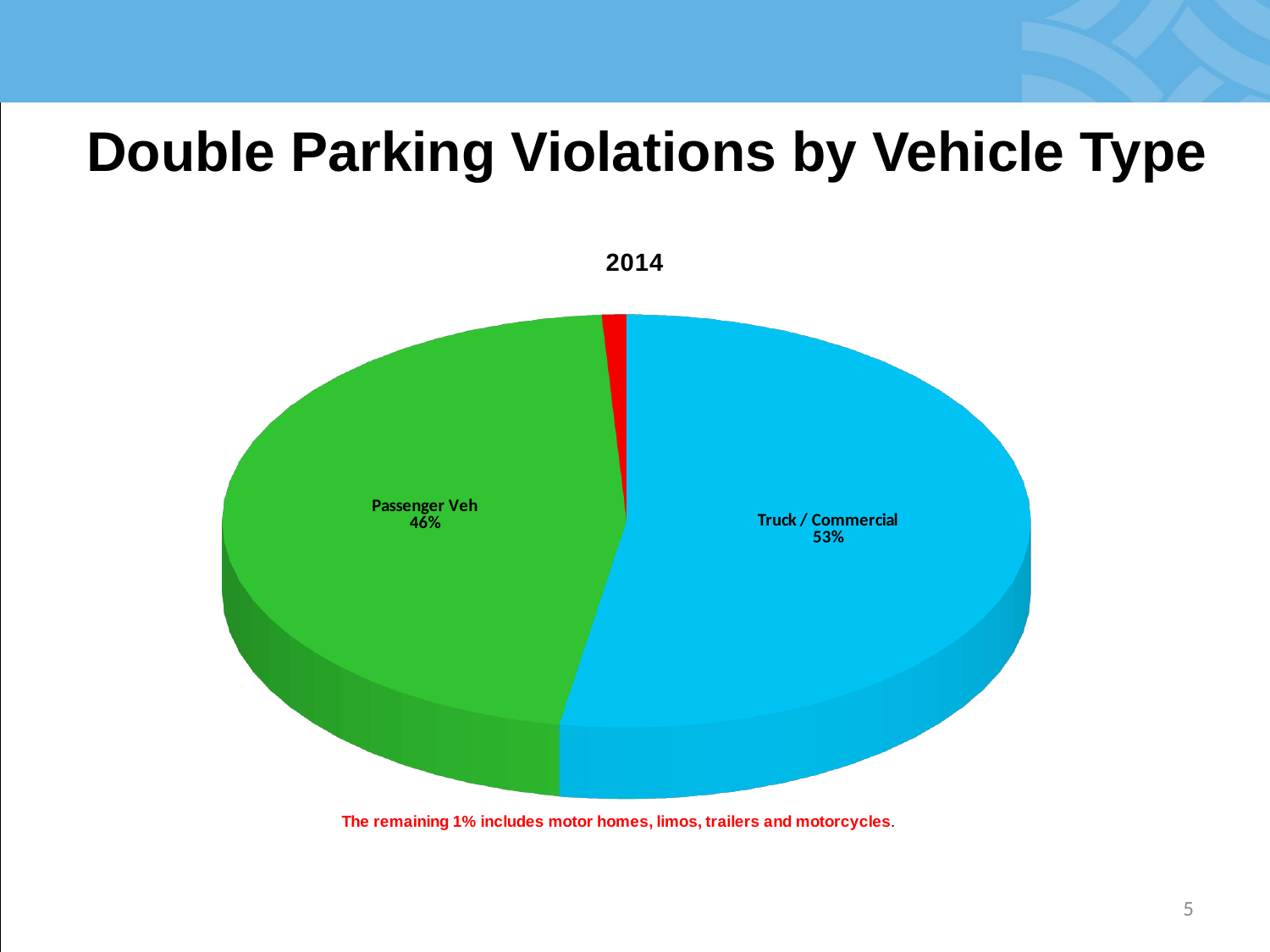
Which labelled vehicle type has the smaller share of double parking violations? Passenger Veh What share of double parking violations is attributed to Passenger Veh? 46% What kind of chart is shown on the slide? pie chart Which vehicle type has the largest share of double parking violations? Truck / Commercial What share of double parking violations is attributed to Truck / Commercial vehicles? 53% What share of violations does the note say is made up of motor homes, limos, trailers and motorcycles? 1% What is the combined share of Passenger Veh and Truck / Commercial violations? 99% What is the difference in percentage points between the Truck / Commercial share and the Passenger Veh share? 7 What year does the chart title indicate the data is for? 2014 How many slices does the pie chart have? 3 Which is larger: the share for Passenger Veh or the share for Truck / Commercial? Truck / Commercial What colour is the Truck / Commercial slice of the pie? blue